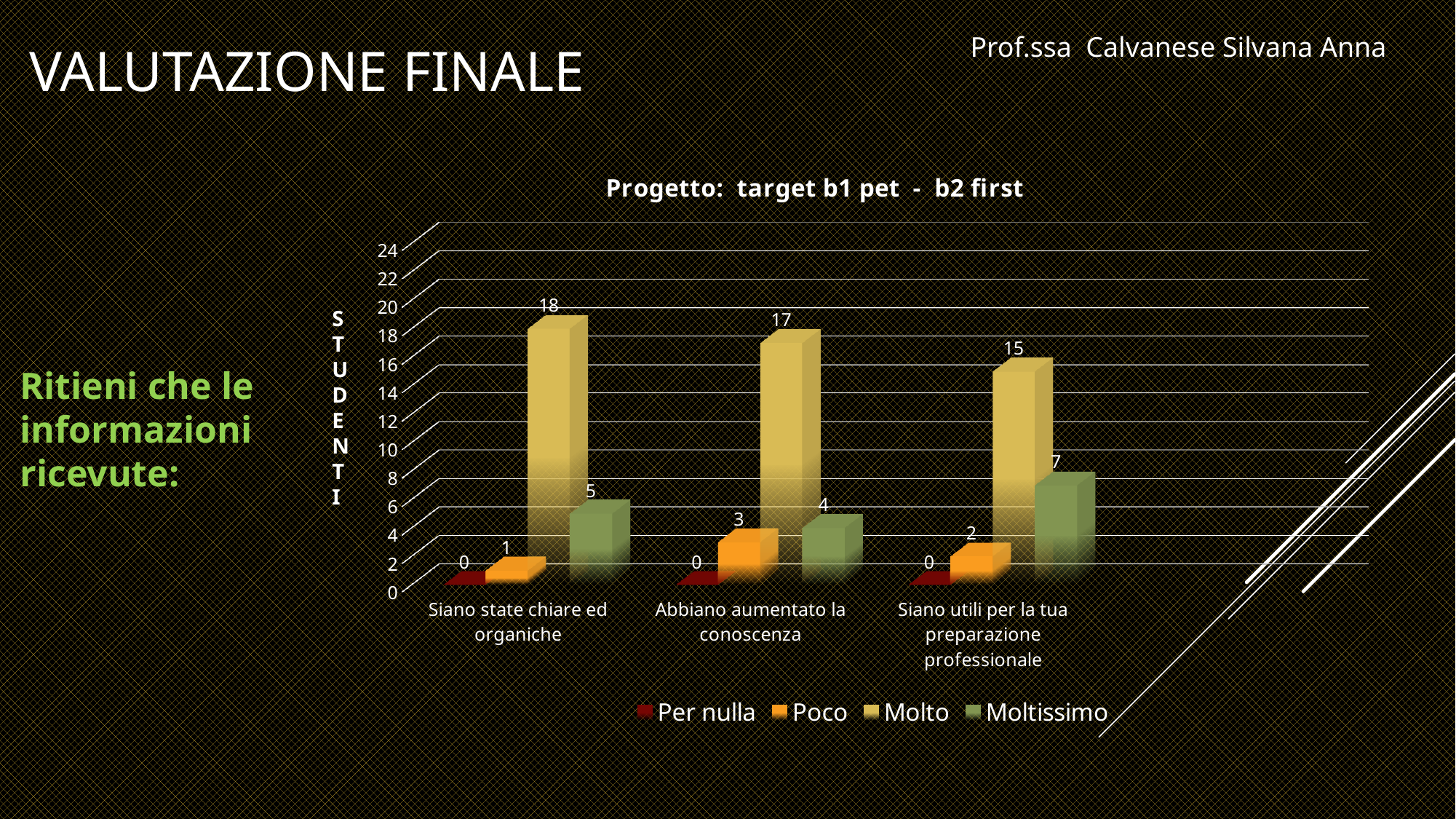
Which is larger: the "Poco" value for "Abbiano aumentato la conoscenza" or the "Poco" value for "Siano utili per la tua preparazione professionale"? Abbiano aumentato la conoscenza What is the value for "Per nulla" in the category "Siano state chiare ed organiche"? 0 How many categories are shown on the x axis? 3 What is the value for "Moltissimo" in the category "Siano utili per la tua preparazione professionale"? 7 Which category has the highest value for "Molto"? Siano state chiare ed organiche What is the value for "Molto" in the category "Siano state chiare ed organiche"? 18 What kind of chart is shown on the slide? Bar chart What is the value for "Poco" in the category "Abbiano aumentato la conoscenza"? 3 What is the difference between the "Molto" and "Moltissimo" values in the category "Siano utili per la tua preparazione professionale"? 8 How many series does the legend list? 4 What is the title of the chart? Progetto: target b1 pet - b2 first Which category has the lowest value for "Moltissimo"? Abbiano aumentato la conoscenza